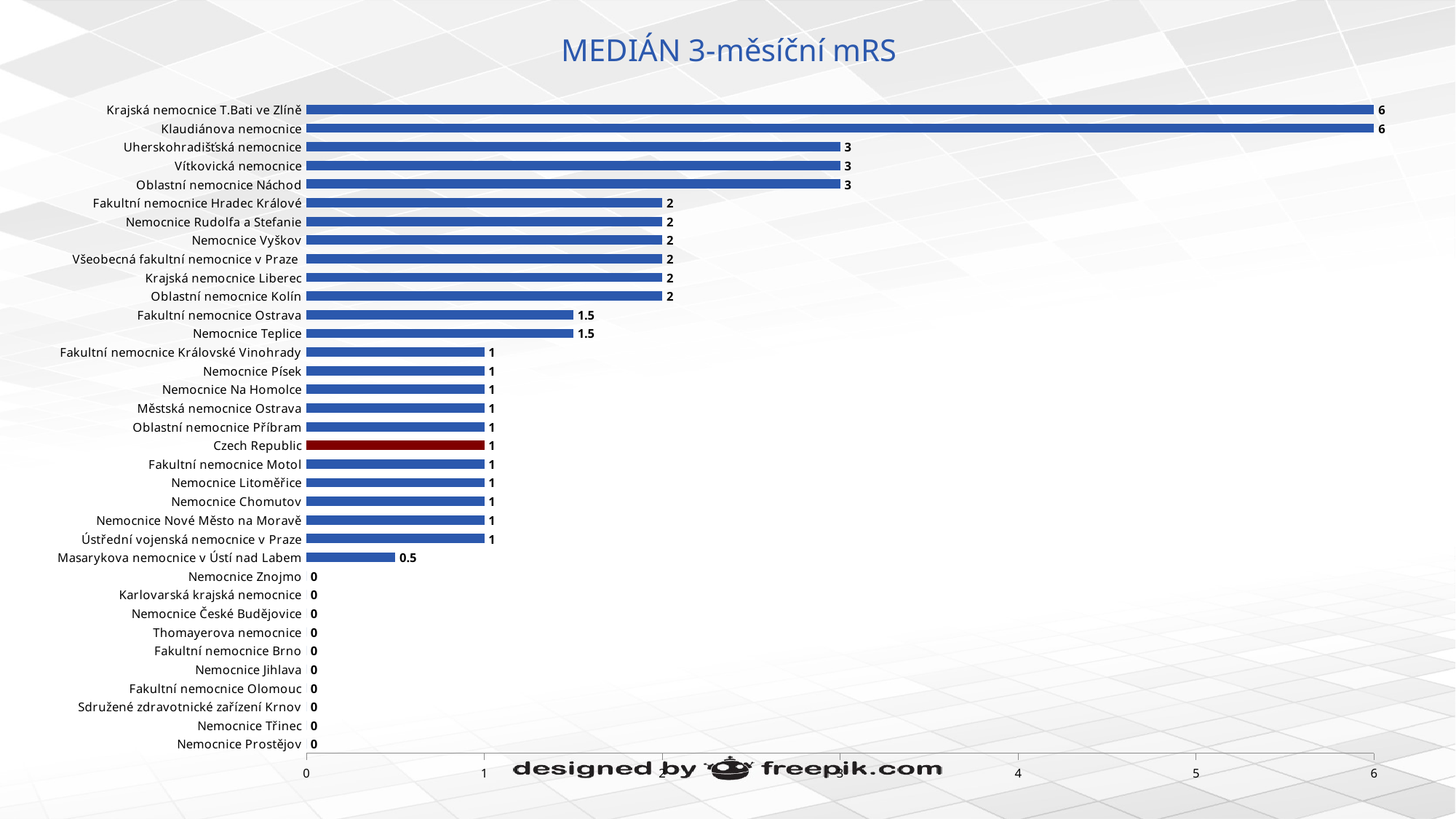
What is the difference between the values for Klaudiánova nemocnice and Nemocnice Teplice? 4.5 What is the value for Masarykova nemocnice v Ústí nad Labem? 0.5 Which has a larger value, Vítkovická nemocnice or Krajská nemocnice Liberec? Vítkovická nemocnice What is the highest value shown on the chart? 6 What is the value for Nemocnice Znojmo? 0 How many categories are shown on the chart? 35 What is the value for Czech Republic? 1 What is the value for Oblastní nemocnice Náchod? 3 What is the title of the chart? MEDIÁN 3-měsíční mRS What kind of chart is shown on the slide? bar chart What is the value for Fakultní nemocnice Ostrava? 1.5 Is the value for Krajská nemocnice T.Bati ve Zlíně greater or less than 4? greater